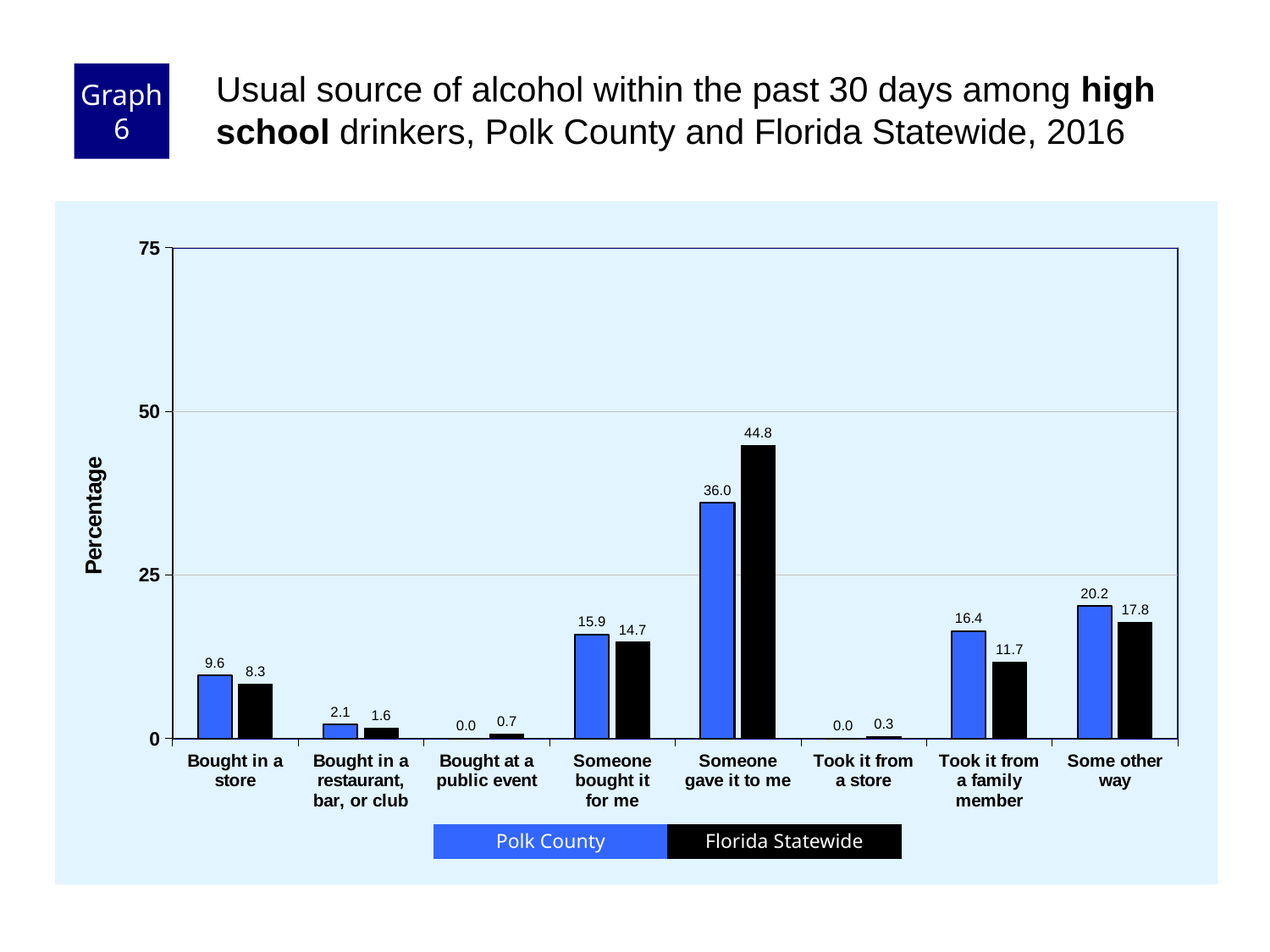
Is the Florida Statewide value for "Someone gave it to me" greater or less than 25? greater How many categories are shown on the x axis? 8 What is the difference between the Florida Statewide and Polk County values for "Someone gave it to me"? 8.8 What is the Polk County value for "Bought in a store"? 9.6 What is the Polk County value for "Someone gave it to me"? 36.0 What is the label of the y axis? Percentage How many series does the legend list? 2 What is the Florida Statewide value for "Took it from a family member"? 11.7 What kind of chart is shown on the slide? bar chart Which category has the highest Florida Statewide value? Someone gave it to me Which is larger for "Some other way": Polk County or Florida Statewide? Polk County Which category has the lowest Florida Statewide value? Took it from a store